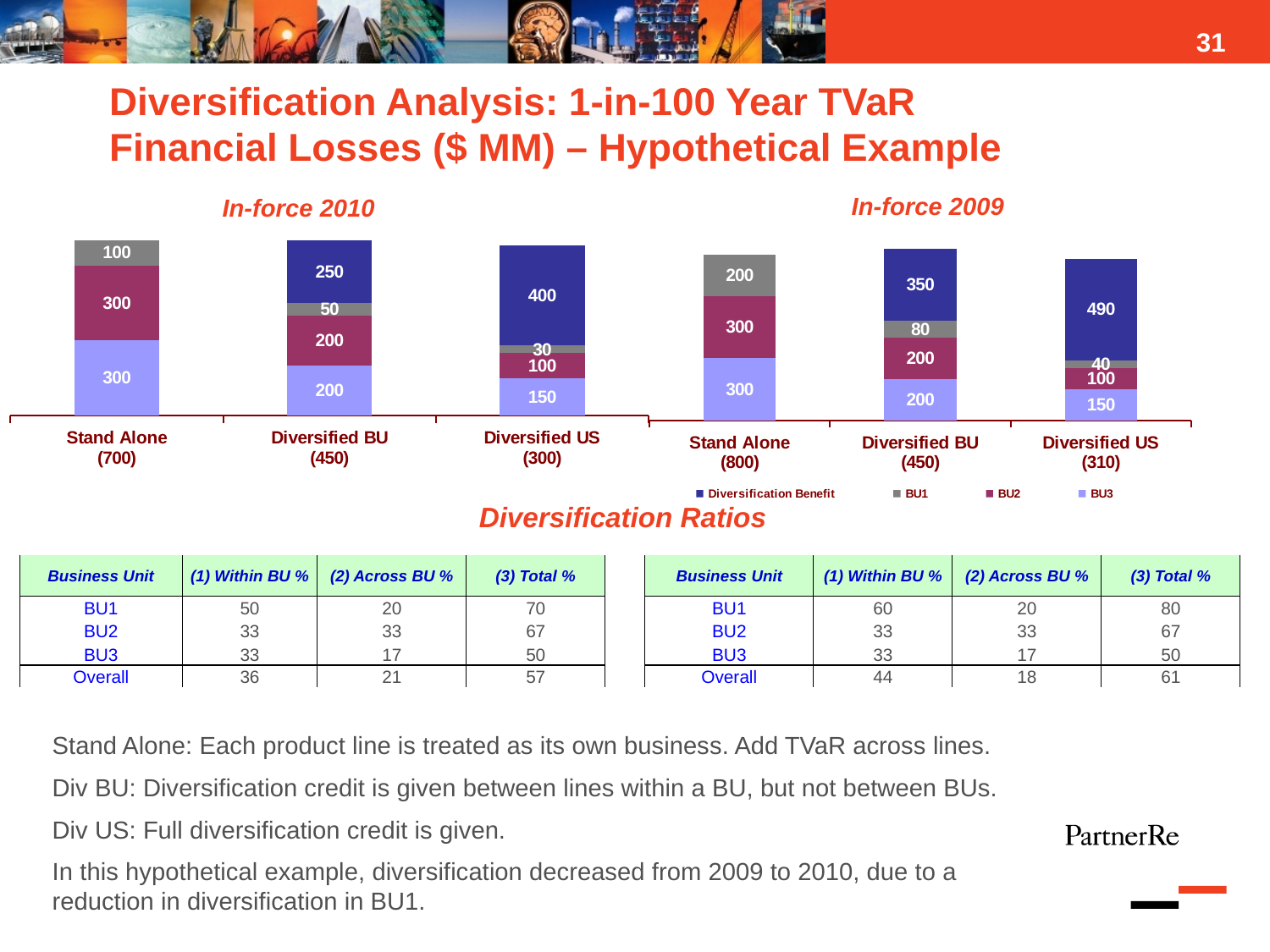
How many series does the legend list for the In-force 2009 chart? 4 In the In-force 2009 chart, which series is shown in dark blue according to the legend? Diversification Benefit In the In-force 2009 chart, what is the Diversification Benefit value for the Diversified BU bar? 350 In the In-force 2010 chart, what is the difference between the BU1 values for Stand Alone and Diversified BU? 50 In the In-force 2010 chart, what is the Diversification Benefit value for the Diversified US bar? 400 In the In-force 2010 chart, which is larger: the BU3 value for Stand Alone or the BU3 value for Diversified US? Stand Alone What type of chart is the In-force 2010 chart? Stacked bar chart In the In-force 2009 chart, what is the total of the BU1, BU2 and BU3 segments in the Stand Alone bar? 800 In the In-force 2010 chart, what is the BU2 value for the Stand Alone bar? 300 In the In-force 2009 chart, what is the difference between the Diversification Benefit values for Diversified US and Diversified BU? 140 In the In-force 2009 chart, what is the BU1 value for the Stand Alone bar? 200 How many bars are in the In-force 2010 chart? 3